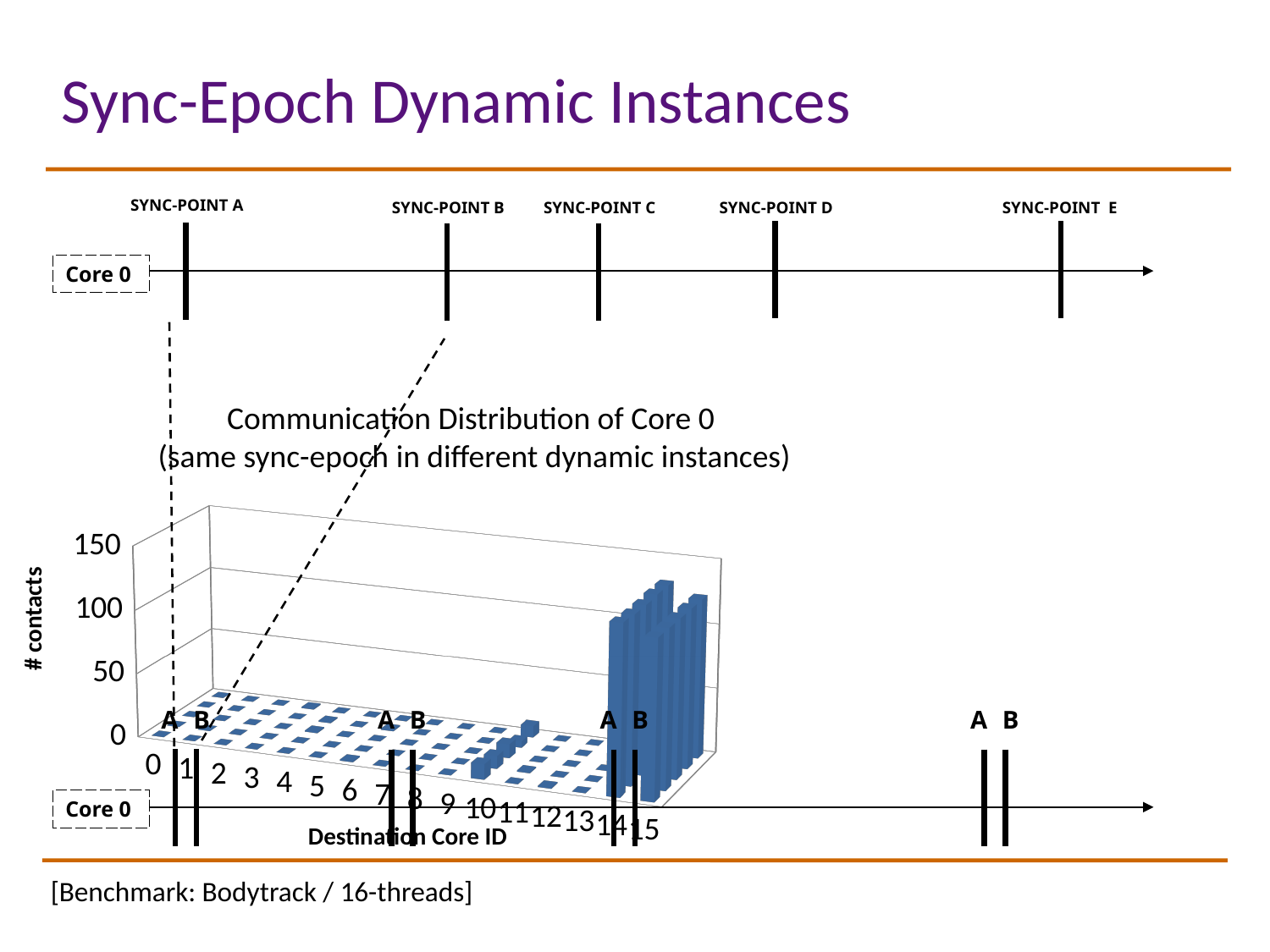
Are the tallest bars in the chart greater or less than 50 contacts? greater Is the number of contacts for Destination Core ID 3 greater or less than 50? less What is the label of the vertical axis of the chart? # contacts Are the bars generally taller at the low end or the high end of the Destination Core ID axis? high end Is the number of contacts for Destination Core ID 0 greater or less than 50? less What kind of chart is shown on the slide? bar chart What is the title of the chart? Communication Distribution of Core 0 (same sync-epoch in different dynamic instances) How many Destination Core ID categories are shown along the x axis of the chart? 16